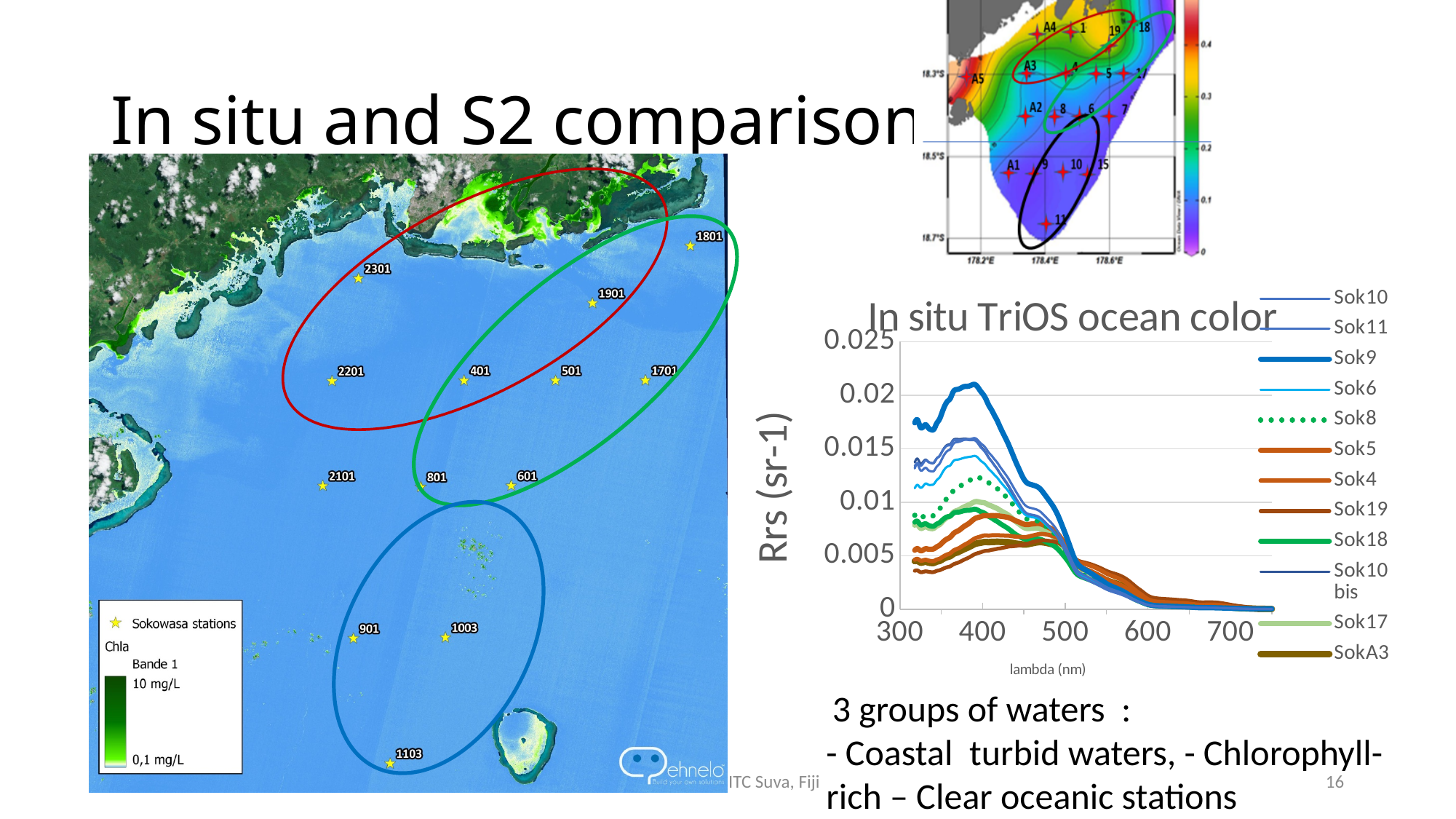
In the 'In situ TriOS ocean color' chart, which series reaches the highest Rrs value? Sok9 In the 'In situ TriOS ocean color' chart, is the peak value of Sok9 greater or less than 0.015? greater What is the label of the x axis of the 'In situ TriOS ocean color' chart? lambda (nm) In the 'In situ TriOS ocean color' chart, is the value of Sok9 at 400 nm greater or less than 0.015? greater What kind of chart is the 'In situ TriOS ocean color' chart? line chart In the 'In situ TriOS ocean color' chart, is the peak value of Sok5 greater or less than 0.01? less In the 'In situ TriOS ocean color' chart, which series has the larger peak value, Sok9 or Sok5? Sok9 In the 'In situ TriOS ocean color' chart, do the Rrs values rise or fall between 400 nm and 700 nm? fall What is the title of the line chart on the right of the slide? In situ TriOS ocean color How many series does the legend of the 'In situ TriOS ocean color' chart list? 12 What is the highest tick value shown on the y axis of the 'In situ TriOS ocean color' chart? 0.025